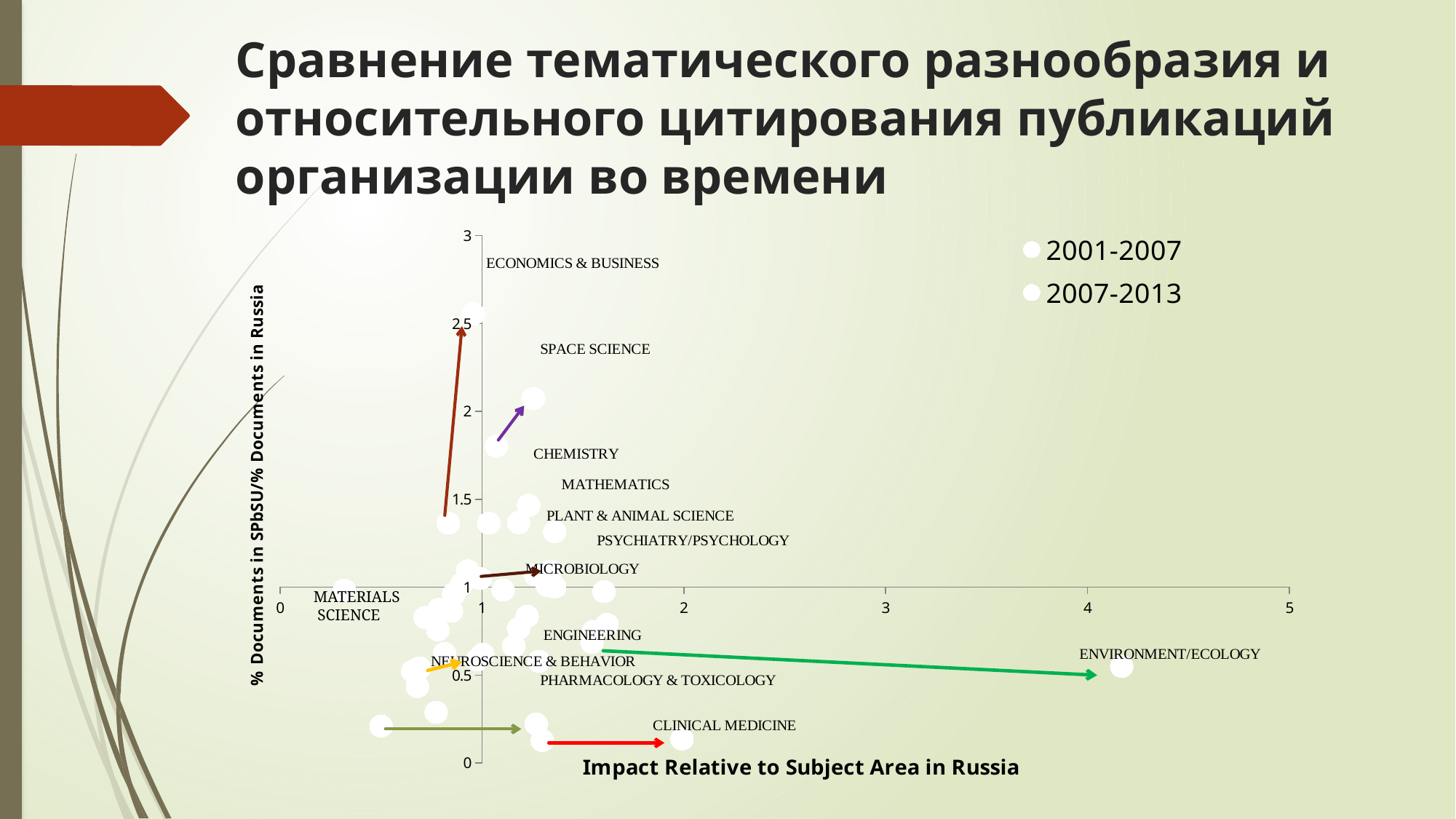
Which subject area's point is higher on the vertical axis, SPACE SCIENCE or MICROBIOLOGY? SPACE SCIENCE Which subject area has the point farthest to the right on the chart, ENVIRONMENT/ECOLOGY or CLINICAL MEDICINE? ENVIRONMENT/ECOLOGY Is the vertical-axis value for SPACE SCIENCE greater or less than 1.5? greater Is the horizontal-axis value for ENVIRONMENT/ECOLOGY greater or less than 3? greater What are the two series named in the chart legend? 2001-2007 and 2007-2013 What is the title of the horizontal axis of the chart? Impact Relative to Subject Area in Russia Is the vertical-axis value for CLINICAL MEDICINE greater or less than 0.5? less How many series does the chart legend list? 2 What kind of chart is shown on the slide? scatter chart What is the highest value shown on the horizontal axis of the chart? 5